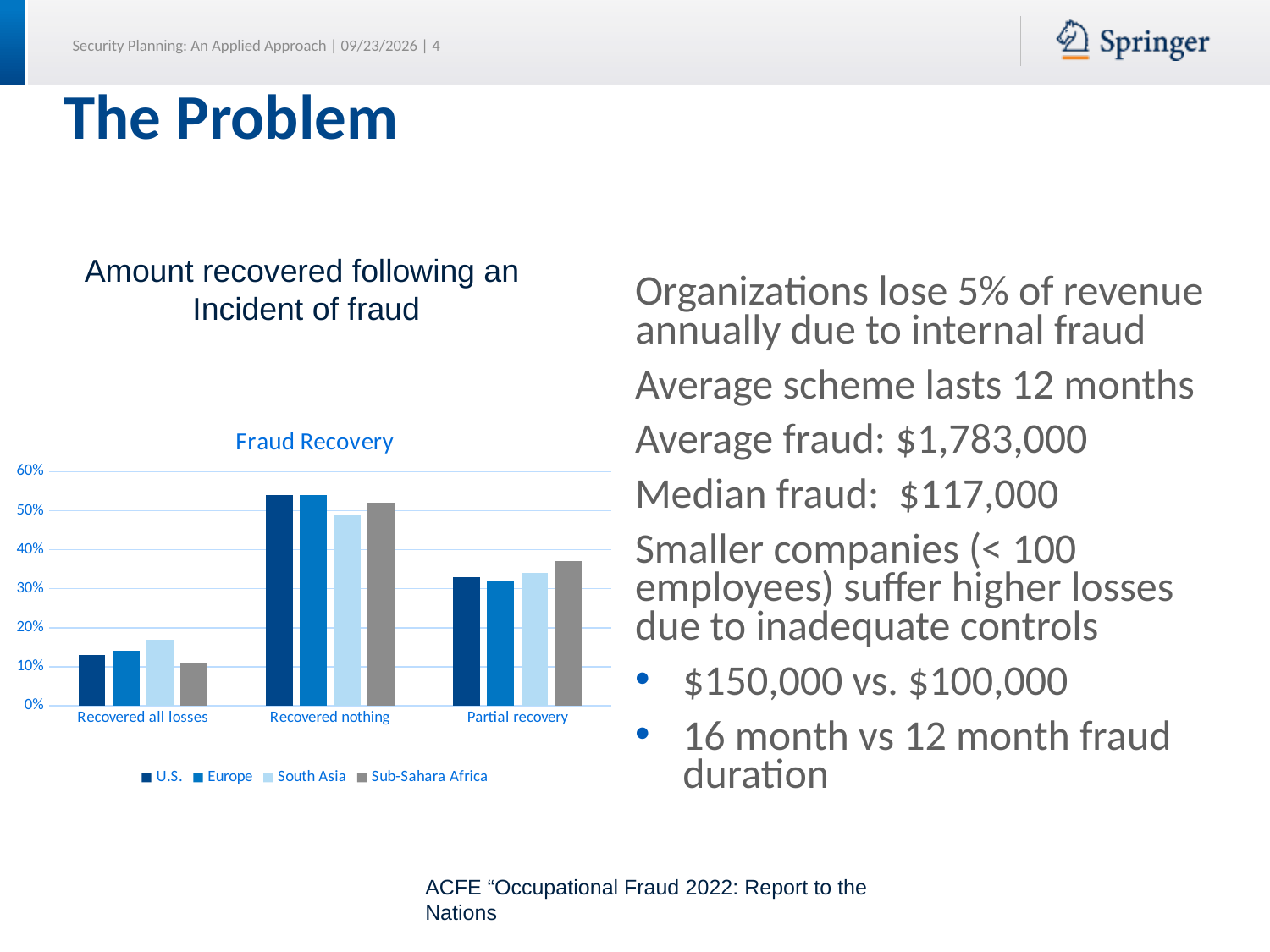
In the Fraud Recovery chart, for Recovered all losses, which is larger: the South Asia value or the Sub-Sahara Africa value? South Asia Which series are listed in the legend of the Fraud Recovery chart? U.S., Europe, South Asia, Sub-Sahara Africa How many series does the legend of the Fraud Recovery chart list? 4 In the Fraud Recovery chart, is the U.S. value for Recovered nothing greater or less than 50%? greater What kind of chart is the Fraud Recovery chart? bar chart In the Fraud Recovery chart, which category has the highest value for the U.S. series? Recovered nothing In the Fraud Recovery chart, which category has the lowest value for the Europe series? Recovered all losses In the Fraud Recovery chart, is the Sub-Sahara Africa value for Partial recovery greater or less than 30%? greater How many categories are shown on the x axis of the Fraud Recovery chart? 3 In the Fraud Recovery chart, is the Sub-Sahara Africa value for Recovered all losses greater or less than 20%? less What is the title of the chart on the slide? Fraud Recovery